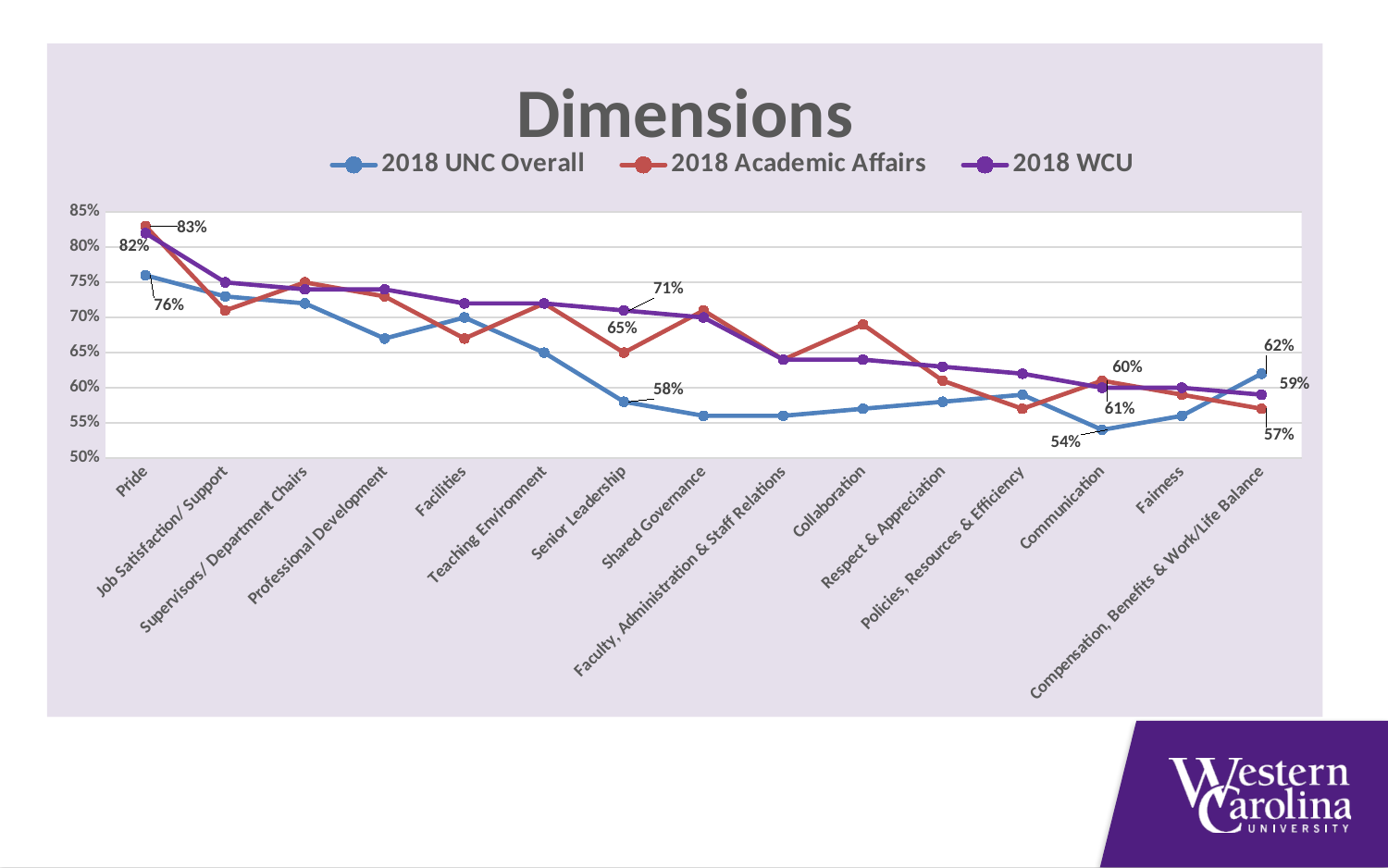
What is the 2018 UNC Overall value for Compensation, Benefits & Work/Life Balance? 62% What is the 2018 WCU value for Senior Leadership? 71% Is the 2018 UNC Overall value for Shared Governance greater or less than 60%? less How many dimensions (categories) are plotted along the x axis? 15 What is the 2018 UNC Overall value for Pride? 76% Does the 2018 WCU line generally rise or fall from left to right across the dimensions? Fall For Compensation, Benefits & Work/Life Balance, which is larger: 2018 UNC Overall or 2018 Academic Affairs? 2018 UNC Overall What is the 2018 UNC Overall value for Communication? 54% How many series does the legend list? 3 What is the 2018 Academic Affairs value for Pride? 83% What type of chart is shown on the slide? Line chart For Pride, how many percentage points higher is 2018 Academic Affairs than 2018 UNC Overall? 7 percentage points